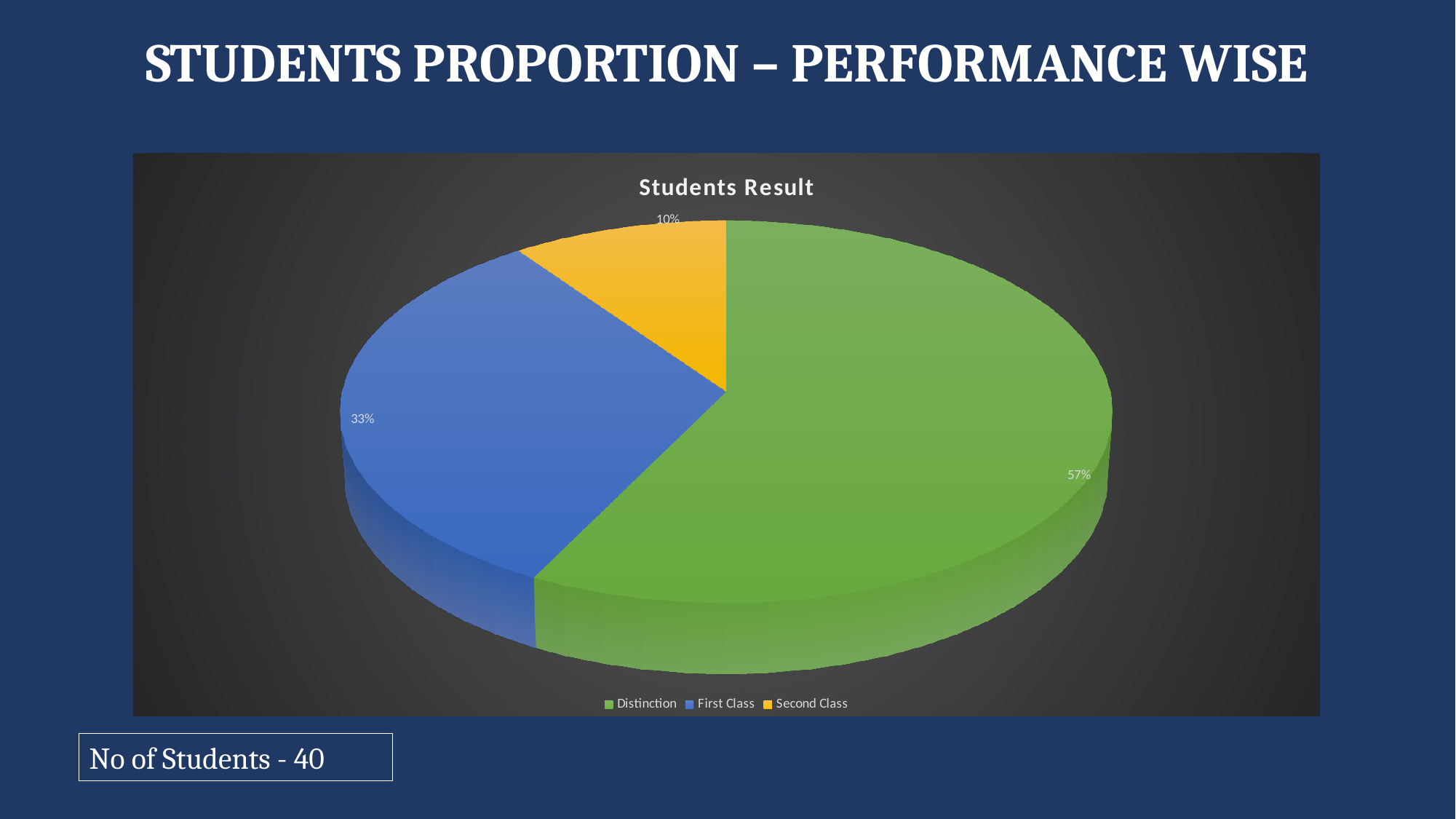
What percentage of students achieved Distinction? 57% What percentage of students achieved First Class? 33% How many categories does the legend list? 3 What is the difference in percentage points between Distinction and First Class? 24 Which is larger, the share for First Class or the share for Second Class? First Class What type of chart is shown on the slide? Pie chart What is the title of the chart? Students Result What percentage of students achieved Second Class? 10% What is the difference in percentage points between First Class and Second Class? 23 Which category has the largest share of the pie? Distinction What colour represents Second Class in the chart? Yellow Which category has the smallest share of the pie? Second Class